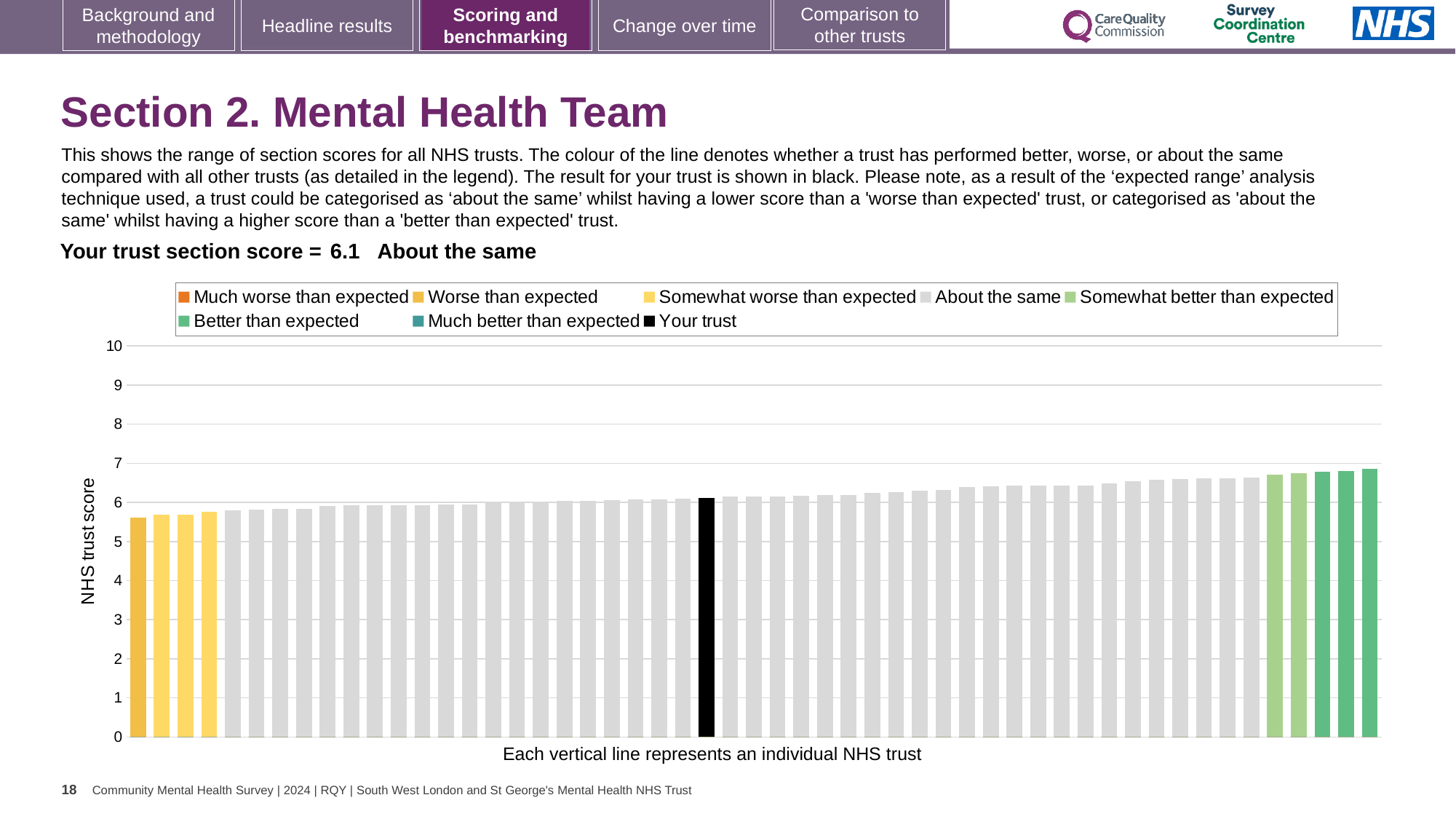
What is the trust section score shown for your trust? 6.1 Which bar is higher, the leftmost bar or the rightmost bar? The rightmost bar How many entries does the chart legend list? 8 What kind of chart is used to show the range of section scores? Bar chart What is the label on the vertical axis of the chart? NHS trust score How is your trust's section score categorised relative to other trusts? About the same Is your trust's score greater or less than 5? greater What colour is the bar representing your trust? Black Is the value of the highest-scoring trust greater or less than 8? less Is the value of the highest-scoring trust greater or less than 7? less Do the trust scores rise or fall from left to right along the x axis? Rise